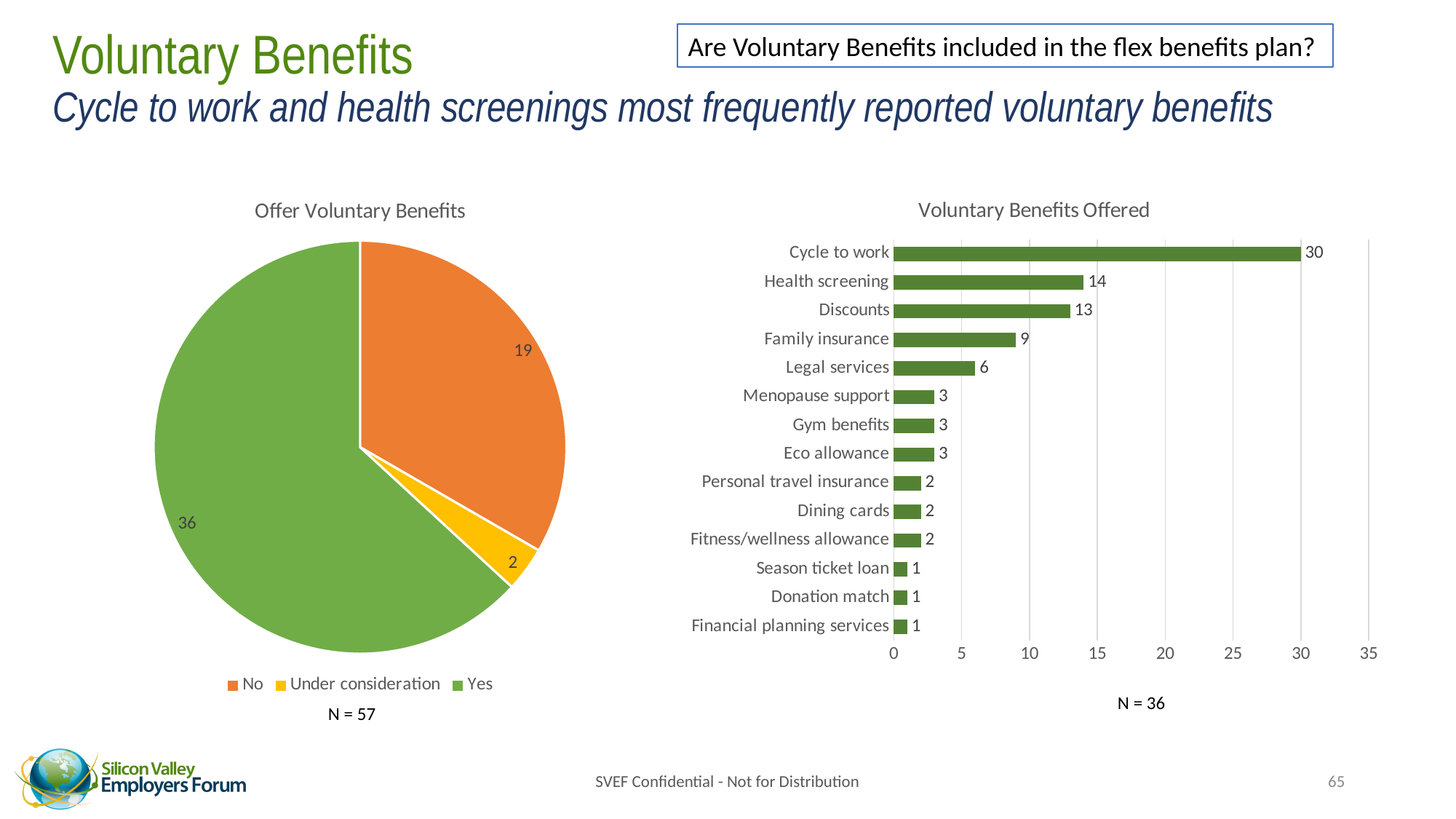
What kind of chart is 'Voluntary Benefits Offered'? Bar chart In the 'Voluntary Benefits Offered' chart, how many categories are plotted? 14 In the 'Voluntary Benefits Offered' chart, what is the value for 'Menopause support'? 3 In the 'Offer Voluntary Benefits' pie chart, what is the value for 'Yes'? 36 In the 'Offer Voluntary Benefits' pie chart, what is the difference between the 'Yes' and 'No' values? 17 In the 'Offer Voluntary Benefits' pie chart, which category has the smallest slice? Under consideration In the 'Voluntary Benefits Offered' chart, which category has the highest value? Cycle to work In the 'Offer Voluntary Benefits' pie chart, what is the value for 'No'? 19 In the 'Offer Voluntary Benefits' pie chart, how many categories does the legend list? 3 In the 'Voluntary Benefits Offered' chart, what is the value for 'Health screening'? 14 In the 'Voluntary Benefits Offered' chart, what is the difference between 'Cycle to work' and 'Discounts'? 17 In the 'Voluntary Benefits Offered' chart, which is larger: 'Family insurance' or 'Legal services'? Family insurance